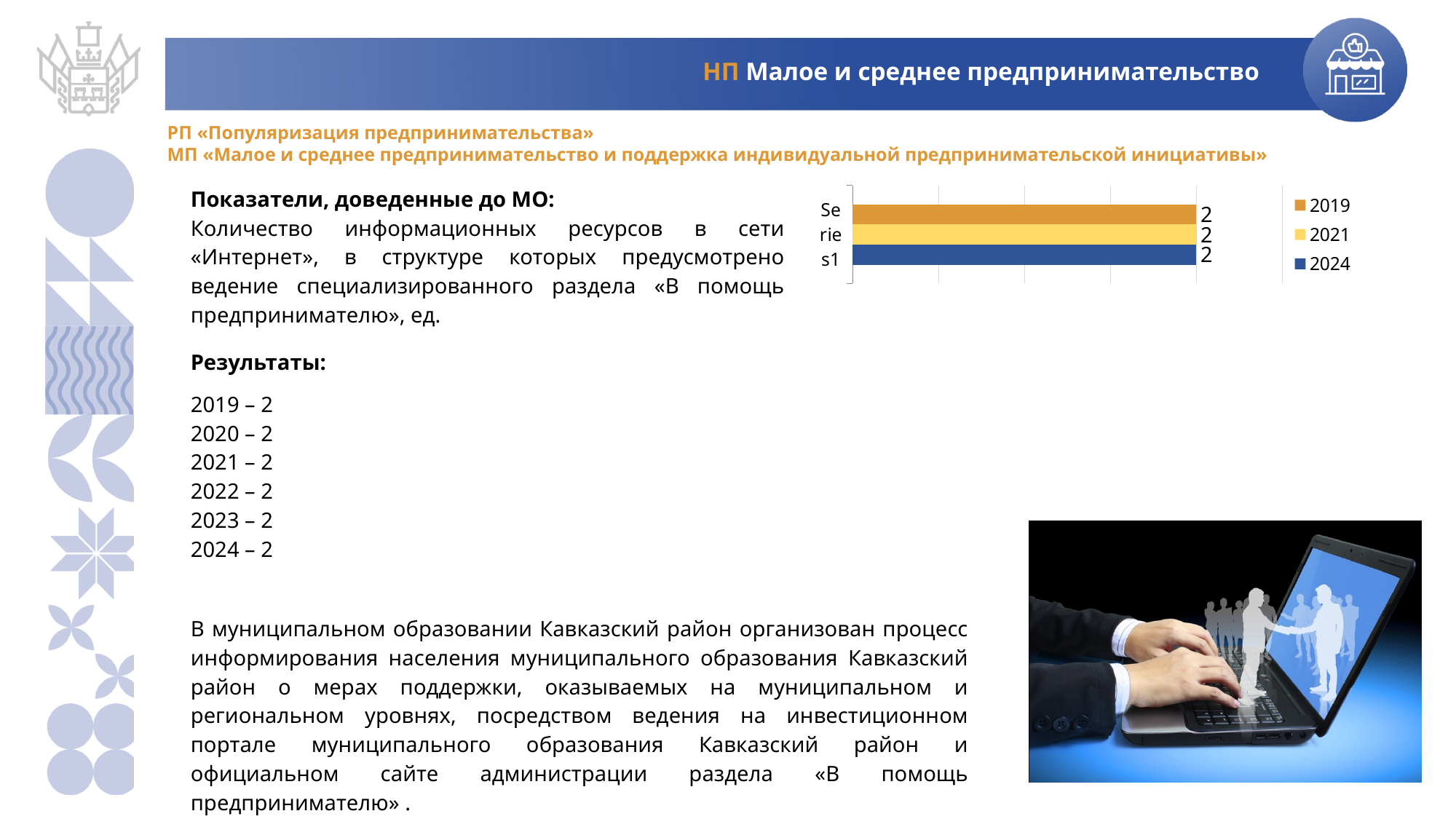
What is the difference between the 2021 value and the 2024 value in the chart? 0 What is the value of the 2024 bar in the chart? 2 How many series does the chart legend list? 3 How many categories are shown on the vertical axis of the chart? 1 What is the difference between the 2024 value and the 2019 value in the chart? 0 What is the value of the 2021 bar in the chart? 2 What colour is the 2024 series in the chart? blue What is the value of the 2019 bar in the chart? 2 Which years are listed in the chart legend? 2019, 2021, 2024 What kind of chart is shown on the slide? bar chart